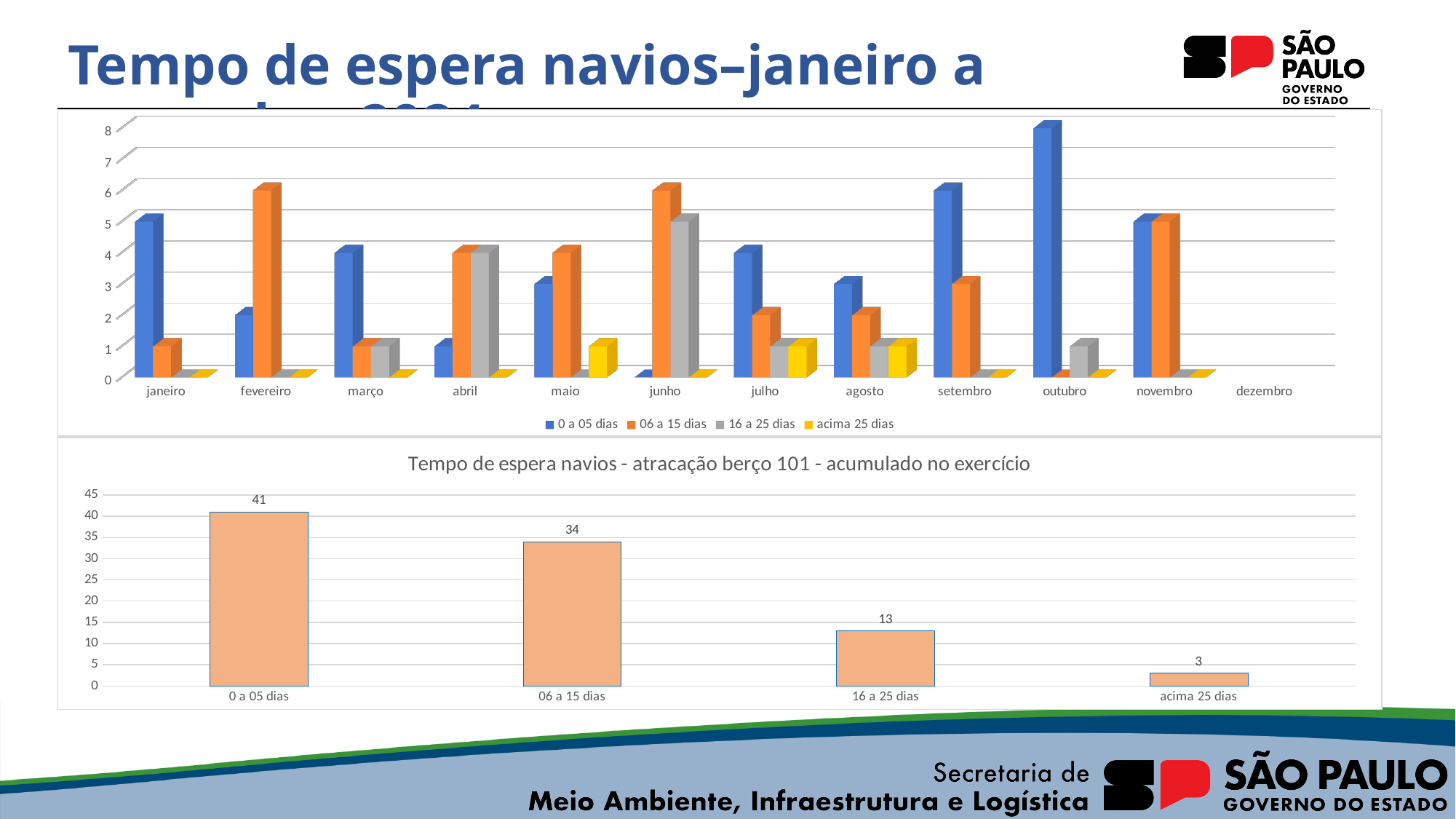
In the bottom chart, which category has the highest value? 0 a 05 dias How many series does the legend of the top chart list? 4 In the bottom chart, what is the sum of the values of all four categories? 91 In the top chart, is the value of '0 a 05 dias' for outubro greater or less than 7? greater In the bottom chart, what is the difference between the values for '0 a 05 dias' and '06 a 15 dias'? 7 In the top chart, which month has the highest value for the '0 a 05 dias' series? outubro In the bottom chart, which category has the lowest value? acima 25 dias In the bottom chart, what is the value for '16 a 25 dias'? 13 In the bottom chart titled 'Tempo de espera navios - atracação berço 101 - acumulado no exercício', what is the value for '0 a 05 dias'? 41 How many categories are shown in the bottom chart? 4 How many months are shown on the x axis of the top chart? 12 What kind of chart is the bottom chart? bar chart